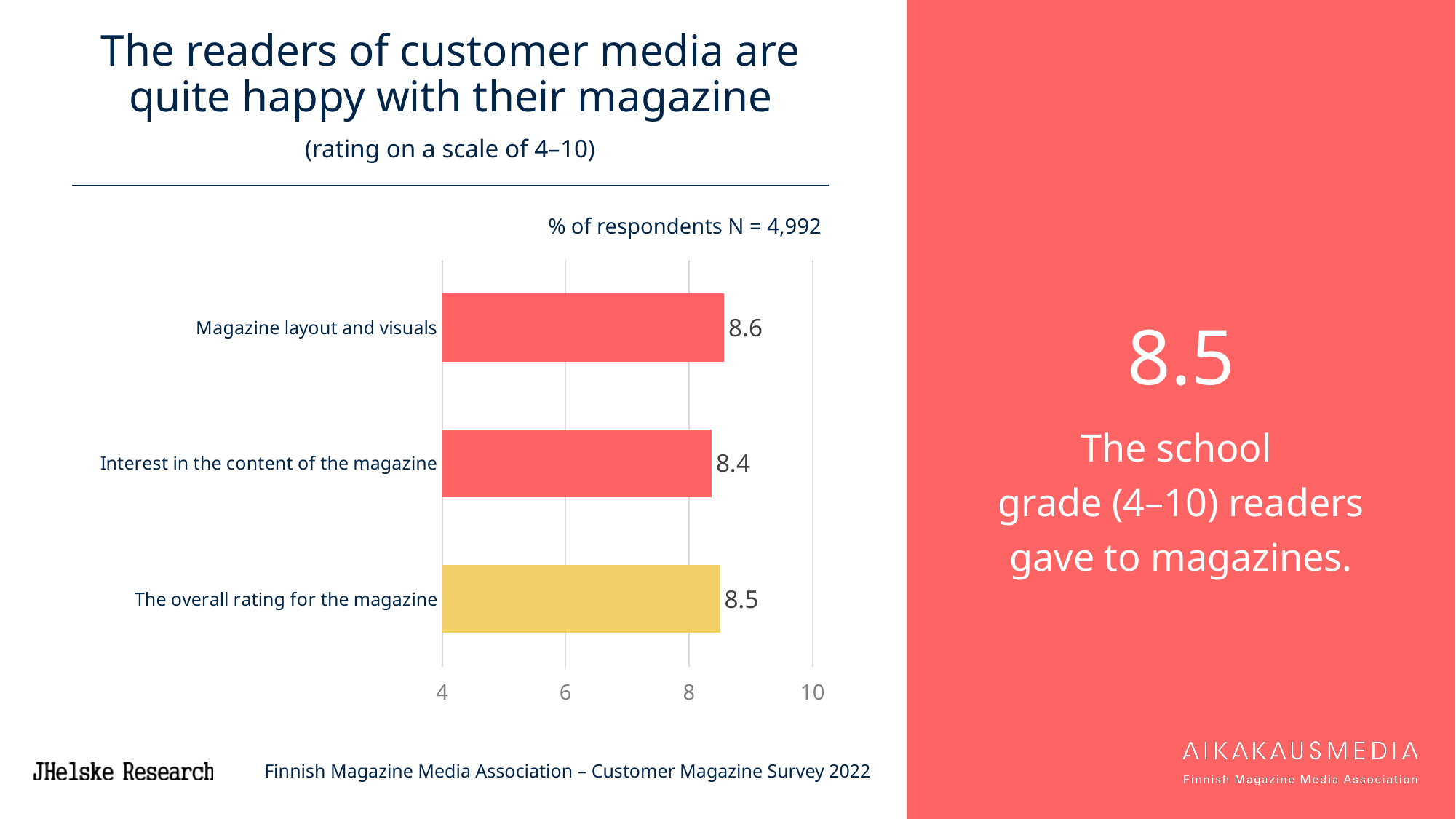
Which category has the highest rating? Magazine layout and visuals What is the overall rating for the magazine? 8.5 What is the number of respondents (N) stated above the chart? 4,992 What is the rating for Interest in the content of the magazine? 8.4 What is the rating for Magazine layout and visuals? 8.6 What kind of chart is shown on the slide? Bar chart Which is higher: the rating for Magazine layout and visuals or the overall rating for the magazine? Magazine layout and visuals What is the difference between the rating for Magazine layout and visuals and the rating for Interest in the content of the magazine? 0.2 How many categories are shown in the chart? 3 Is the rating for Interest in the content of the magazine greater or less than 8? greater Which category has the lowest rating? Interest in the content of the magazine Which bar in the chart is coloured yellow rather than red? The overall rating for the magazine